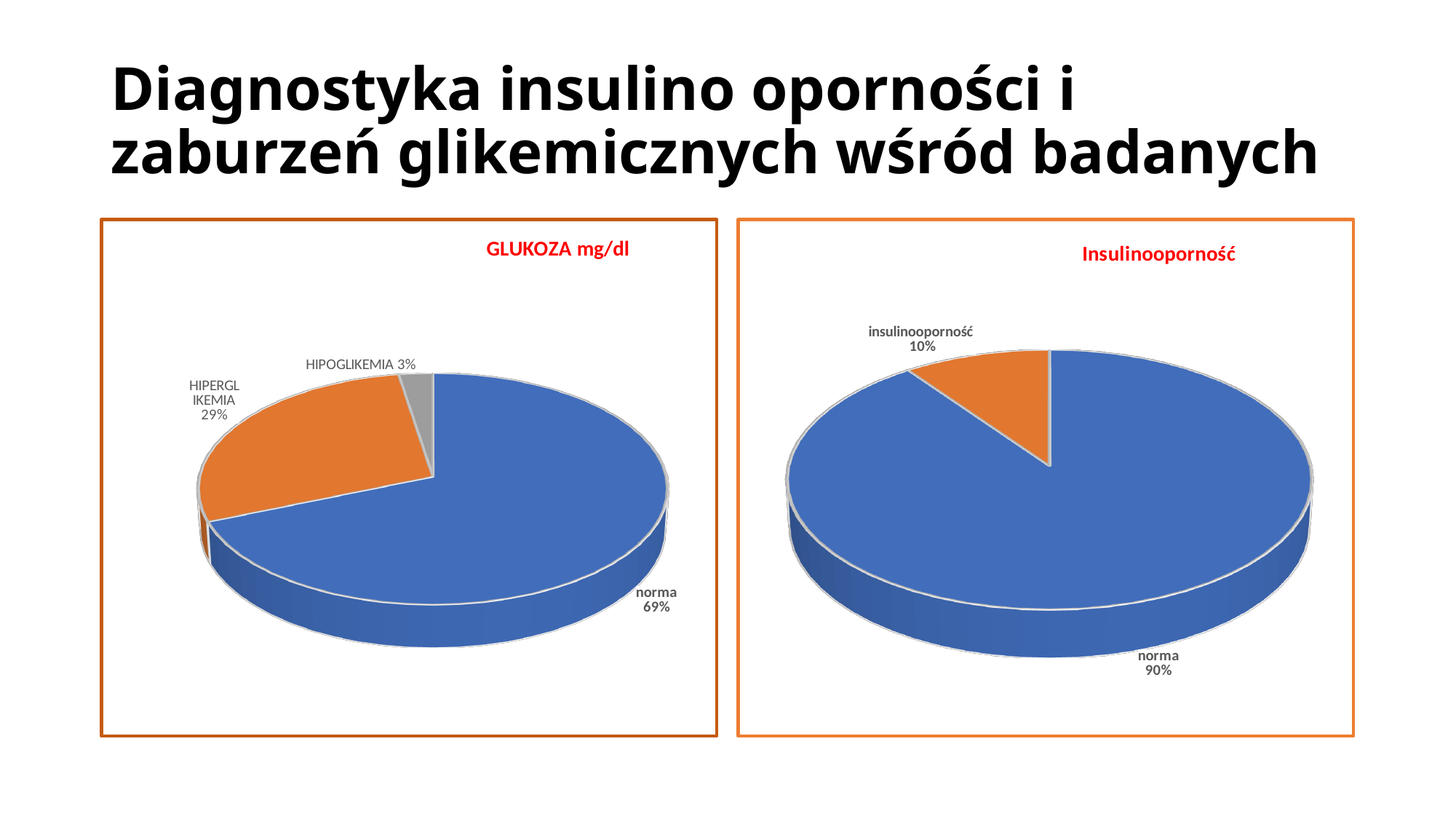
In the 'GLUKOZA mg/dl' chart, what share of the pie is labelled 'HIPERGLIKEMIA'? 29% In the 'GLUKOZA mg/dl' chart, which slice is the smallest? HIPOGLIKEMIA In the 'Insulinooporność' chart, which slice is larger, 'norma' or 'insulinooporność'? norma In the 'GLUKOZA mg/dl' chart, what is the difference between the 'norma' share and the 'HIPERGLIKEMIA' share? 40% In the 'GLUKOZA mg/dl' chart, how many slices does the pie have? 3 In the 'Insulinooporność' chart, how many slices does the pie have? 2 In the 'GLUKOZA mg/dl' chart, what share of the pie is labelled 'HIPOGLIKEMIA'? 3% In the 'GLUKOZA mg/dl' chart, what share of the pie is labelled 'norma'? 69% What kind of chart is the chart on the right of the slide? pie chart In the 'GLUKOZA mg/dl' chart, which slice is the largest? norma